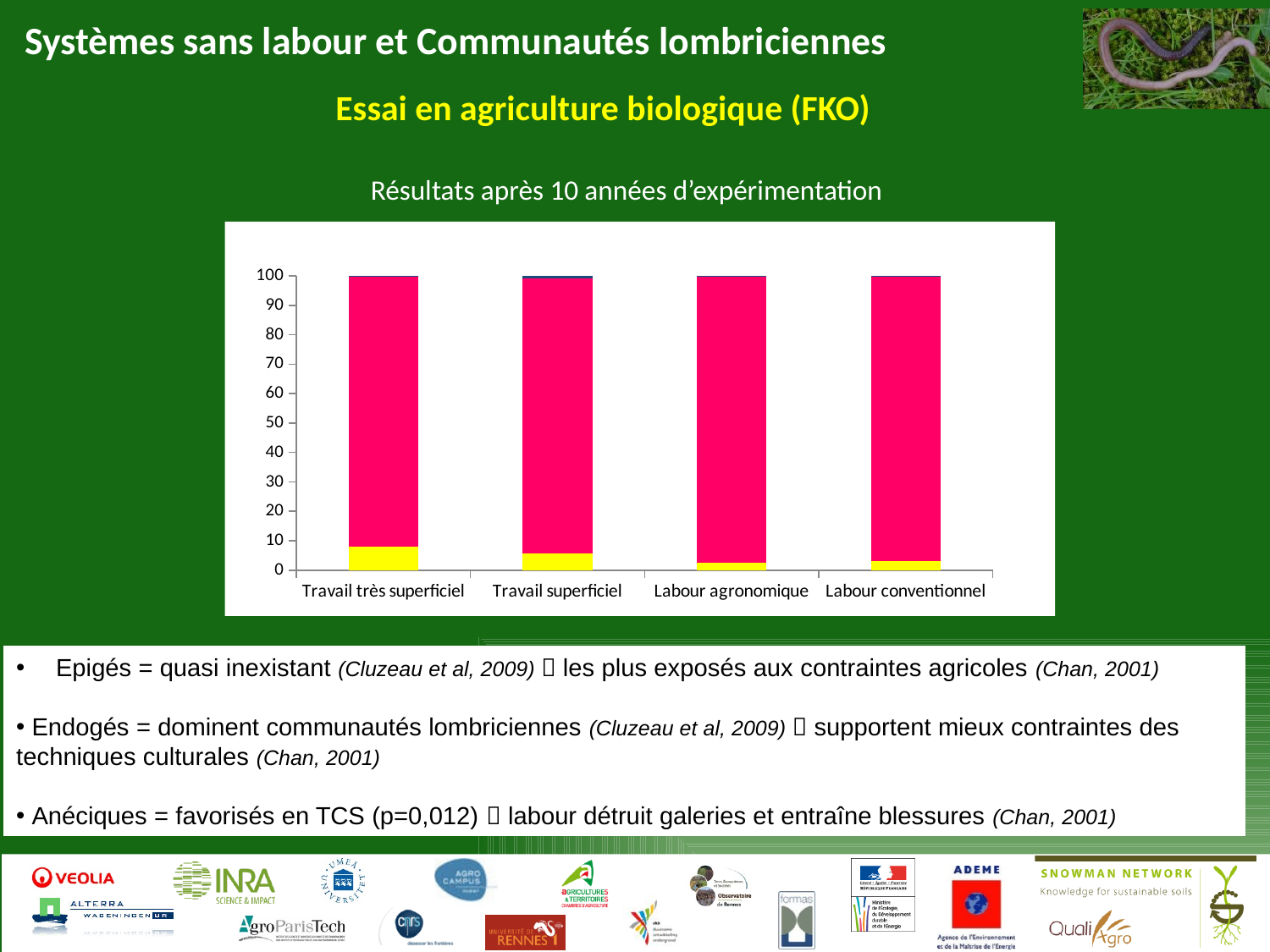
What kind of chart is shown on the slide? stacked bar chart Which has the larger yellow segment, Travail très superficiel or Labour agronomique? Travail très superficiel Is the yellow segment for Labour agronomique greater or less than 10? less What is the highest value shown on the y axis of the chart? 100 Which has the larger yellow segment, Travail superficiel or Labour conventionnel? Travail superficiel Which category has the largest yellow segment? Travail très superficiel Is the yellow segment for Travail très superficiel greater or less than 10? less Is the pink segment for Labour conventionnel greater or less than 90? greater What is the text shown above the chart? Résultats après 10 années d'expérimentation How many categories are shown on the x axis of the chart? 4 Which category is the first one on the x axis of the chart? Travail très superficiel